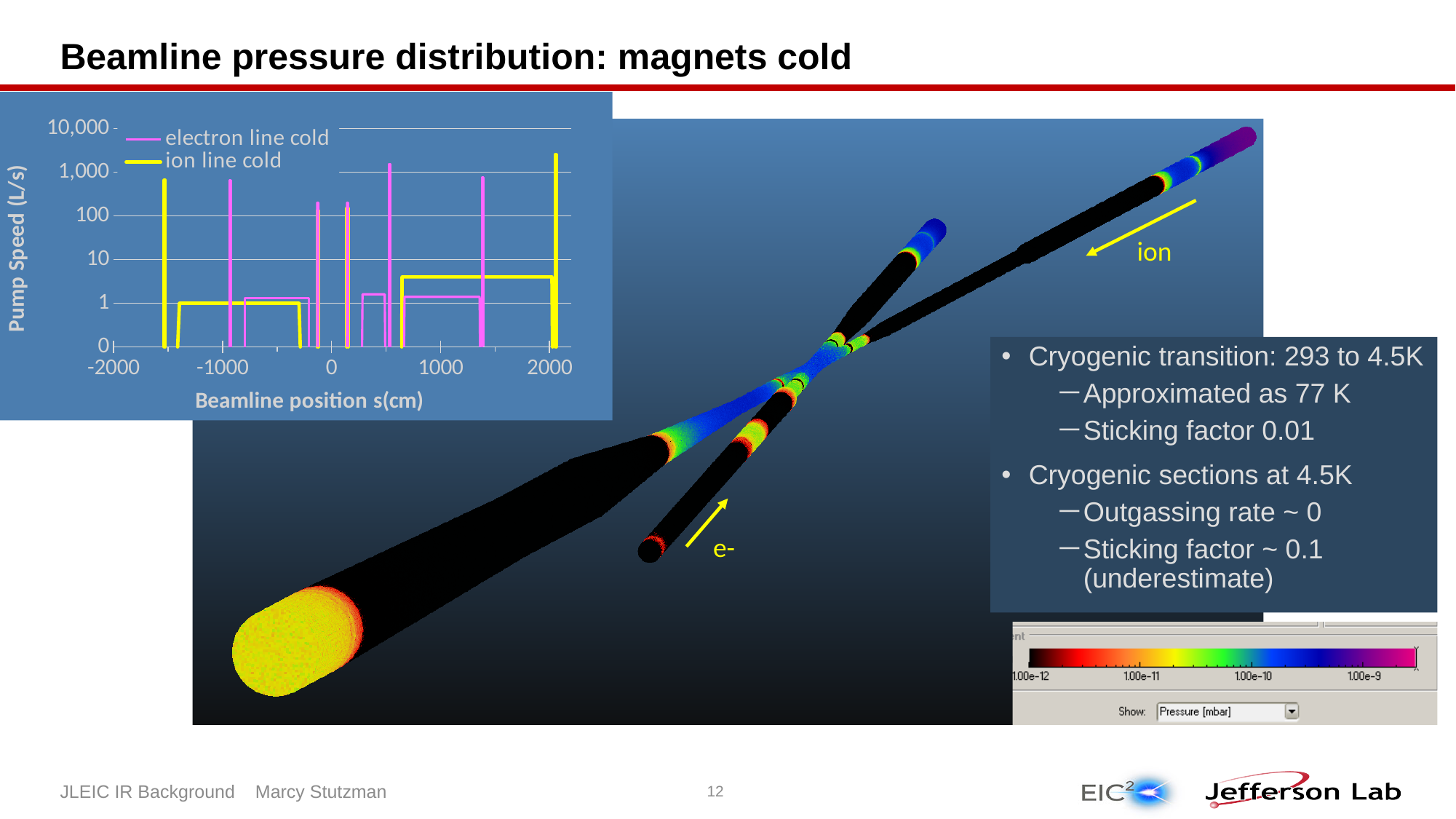
What are the two series named in the chart legend? electron line cold, ion line cold How many series does the chart legend list? 2 Is the ion line cold pump speed between beamline positions 600 and 2000 greater or less than 10 L/s? less Is the peak of the electron line cold series near beamline position 500 greater or less than 1,000 L/s? greater Is the peak of the electron line cold series near beamline position 1400 greater or less than 1,000 L/s? less What is the label of the chart's vertical axis? Pump Speed (L/s) What is the highest tick value shown on the chart's vertical axis? 10,000 What kind of chart is shown on the slide? line chart